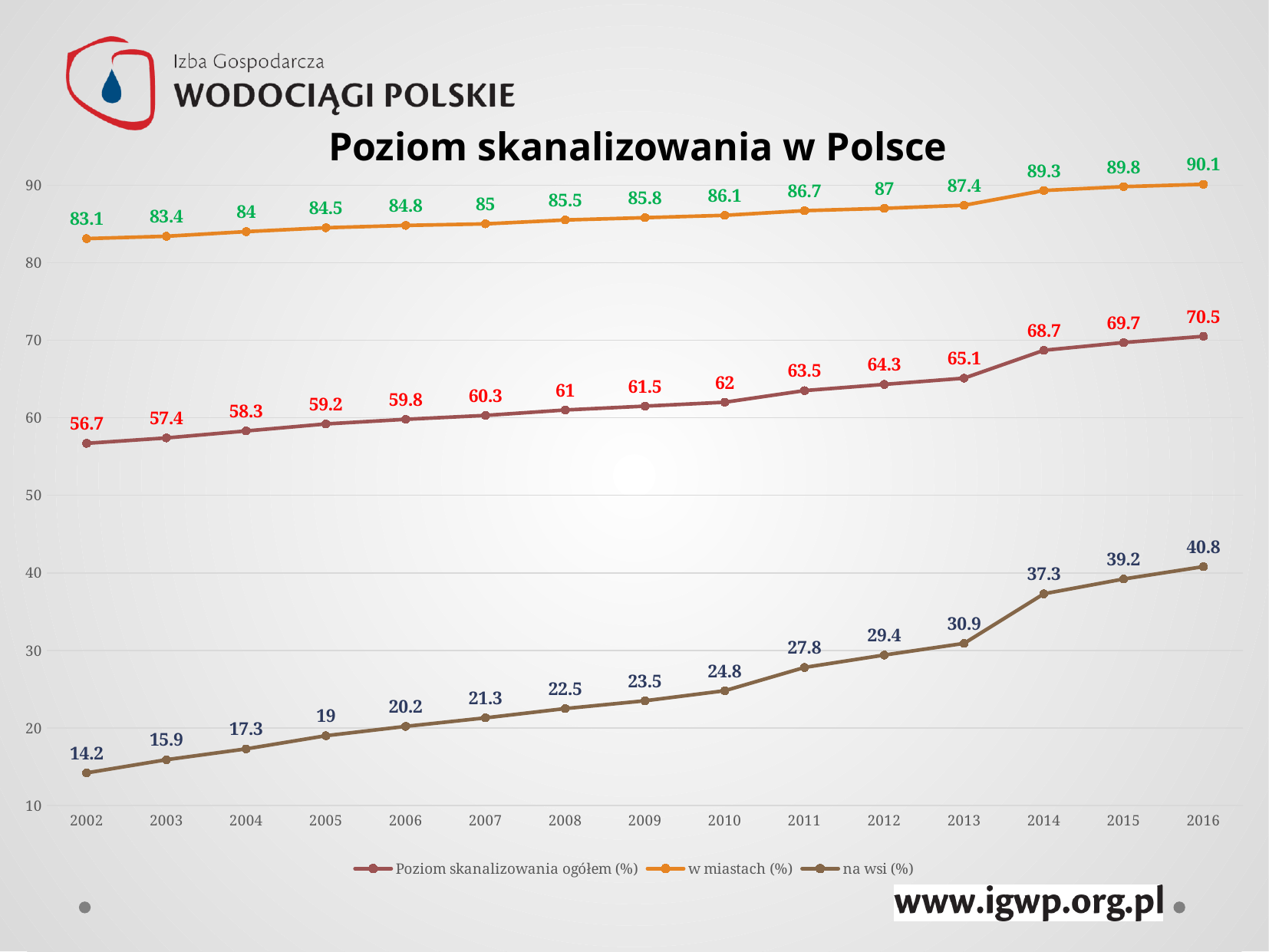
How many series does the legend list? 3 What is the value for "Poziom skanalizowania ogółem (%)" in 2010? 62 What is the value for "na wsi (%)" in 2002? 14.2 How many years are shown on the x axis? 15 In which year is the "Poziom skanalizowania ogółem (%)" series lowest? 2002 In which year is the "na wsi (%)" series highest? 2016 What is the difference between the "w miastach (%)" value and the "na wsi (%)" value in 2016? 49.3 What is the value for "w miastach (%)" in 2016? 90.1 What is the title of the chart? Poziom skanalizowania w Polsce Does the "na wsi (%)" series rise or fall from 2002 to 2016? Rise What kind of chart is shown on the slide? Line chart Which is larger in 2014: the "Poziom skanalizowania ogółem (%)" value or the "na wsi (%)" value? Poziom skanalizowania ogółem (%)